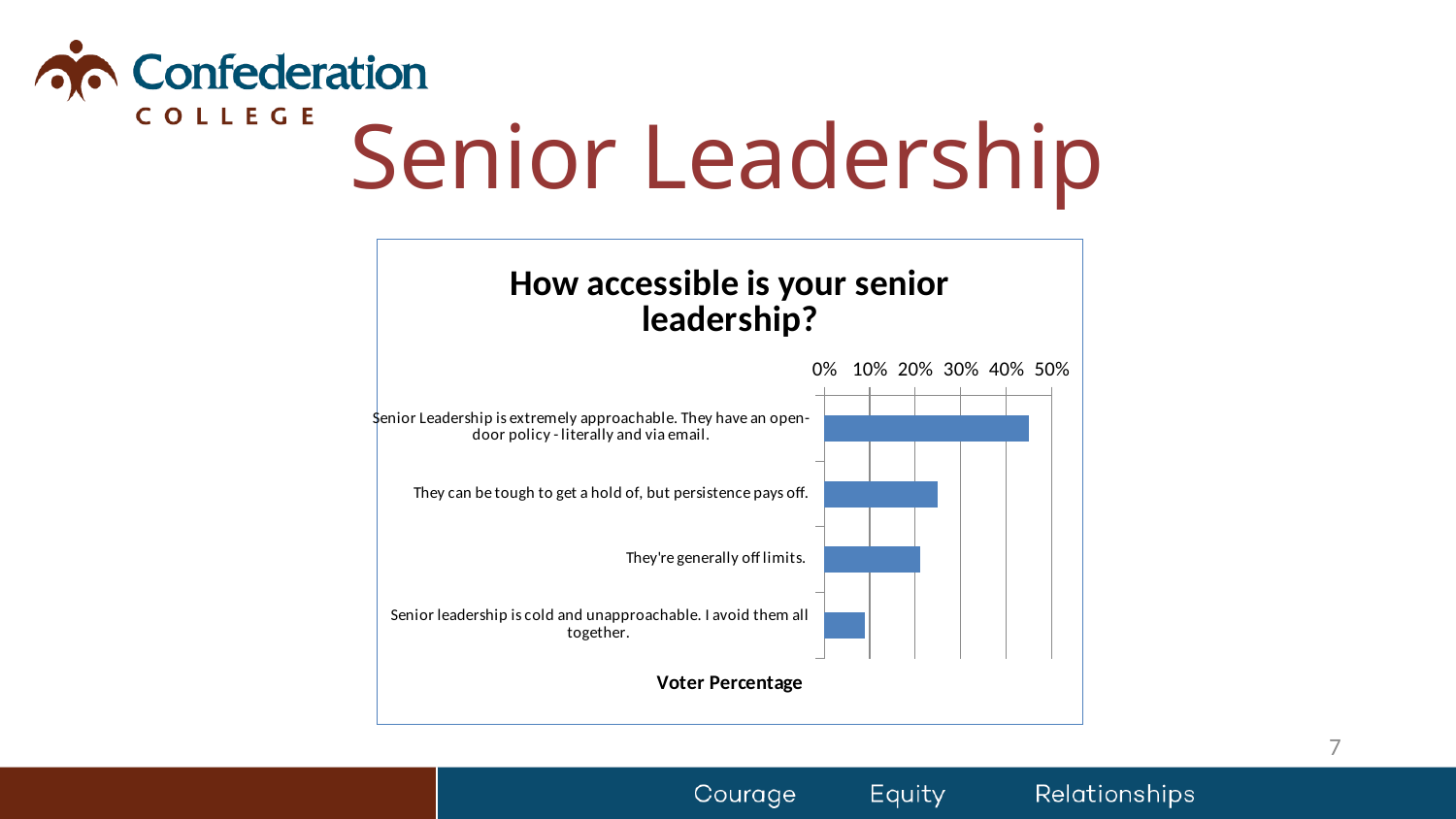
Is the value for "Senior leadership is cold and unapproachable. I avoid them all together." greater or less than 20%? less How many categories (response options) are plotted in the chart? 4 What is the title of the chart? How accessible is your senior leadership? Is the value for "They can be tough to get a hold of, but persistence pays off." greater or less than 30%? less What kind of chart is shown on the slide? bar chart Which has a larger voter percentage: "Senior Leadership is extremely approachable. They have an open-door policy - literally and via email." or "They're generally off limits."? Senior Leadership is extremely approachable. They have an open-door policy - literally and via email. Which has a larger voter percentage: "They can be tough to get a hold of, but persistence pays off." or "Senior leadership is cold and unapproachable. I avoid them all together."? They can be tough to get a hold of, but persistence pays off. Which response option has the lowest voter percentage? Senior leadership is cold and unapproachable. I avoid them all together. Is the value for "They're generally off limits." greater or less than 30%? less Which response option has the highest voter percentage? Senior Leadership is extremely approachable. They have an open-door policy - literally and via email. What is the label of the value axis in the chart? Voter Percentage